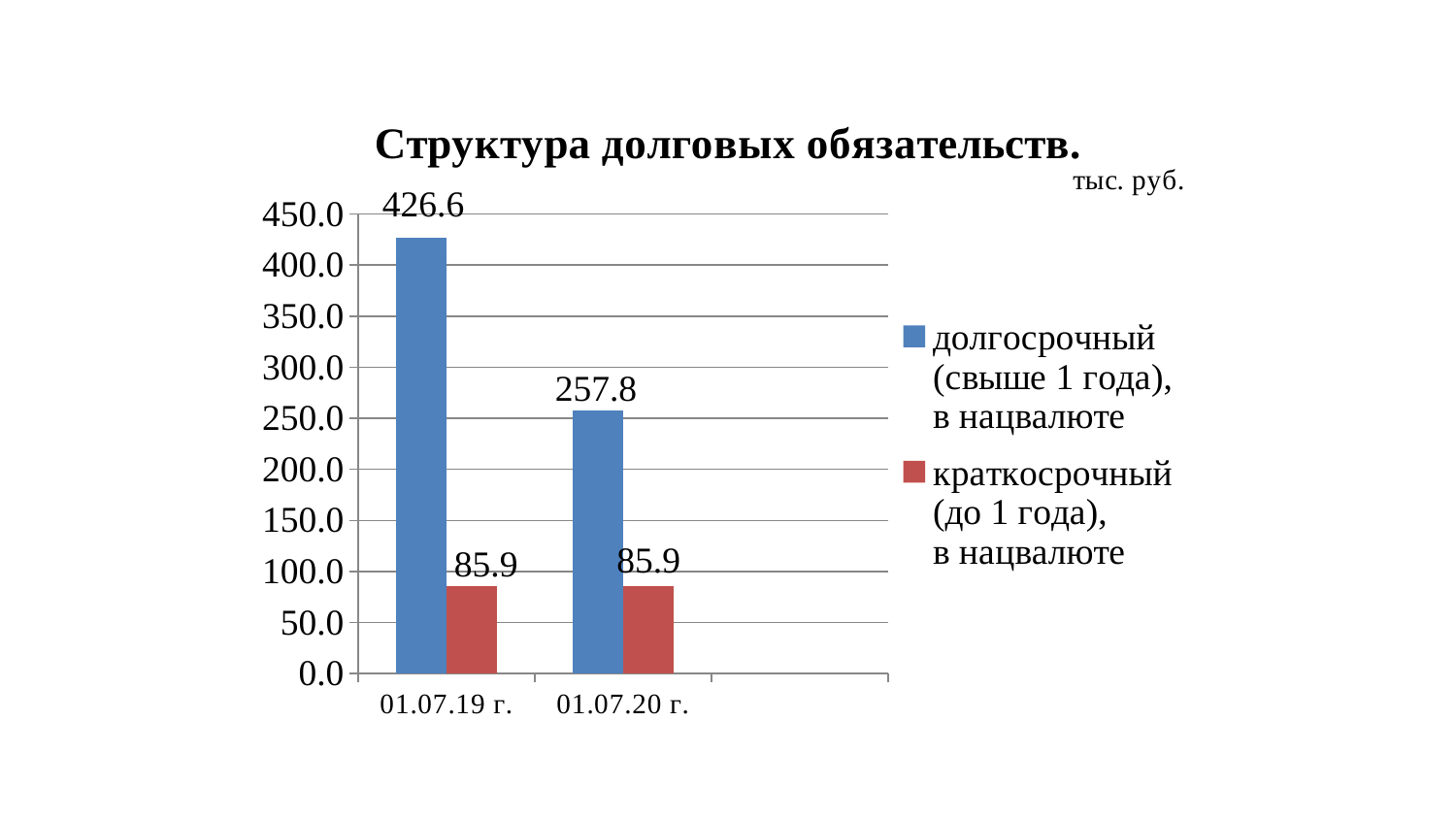
What is the value of краткосрочный (до 1 года), в нацвалюте for 01.07.20 г.? 85.9 Which series has the highest single value on the chart? долгосрочный (свыше 1 года), в нацвалюте Which date has the higher value for долгосрочный (свыше 1 года), в нацвалюте? 01.07.19 г. How many series does the legend list? 2 How many dates (categories) are shown on the x axis? 2 By how much did долгосрочный (свыше 1 года), в нацвалюте decrease from 01.07.19 г. to 01.07.20 г.? 168.8 What is the title of the chart? Структура долговых обязательств. What is the difference between долгосрочный and краткосрочный values for 01.07.20 г.? 171.9 What kind of chart is shown on the slide? bar chart What is the value of краткосрочный (до 1 года), в нацвалюте for 01.07.19 г.? 85.9 What is the value of долгосрочный (свыше 1 года), в нацвалюте for 01.07.20 г.? 257.8 What is the value of долгосрочный (свыше 1 года), в нацвалюте for 01.07.19 г.? 426.6